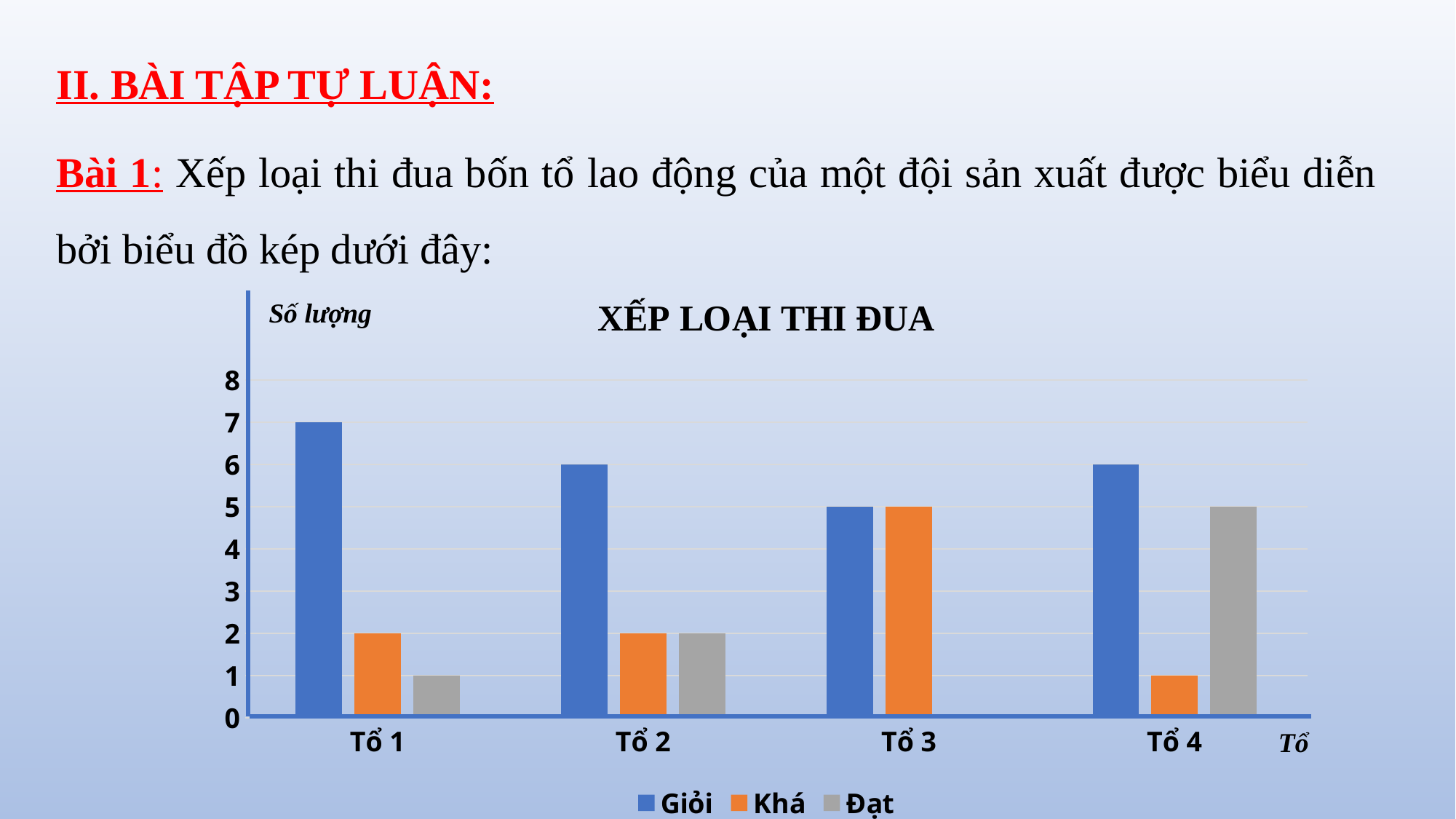
How many categories (tổ) are shown on the x axis of the chart? 4 Which tổ has the lowest Khá value? Tổ 4 Which is larger: the Đạt value for Tổ 2 or the Đạt value for Tổ 4? Tổ 4 What is the difference between the Giỏi value for Tổ 1 and the Giỏi value for Tổ 3? 2 What is the value of Giỏi for Tổ 1? 7 What is the value of Đạt for Tổ 4? 5 What is the value of Khá for Tổ 3? 5 What is the title of the chart? XẾP LOẠI THI ĐUA What kind of chart is shown on the slide? bar chart Which tổ has the highest Giỏi value? Tổ 1 Is the Giỏi value for Tổ 2 greater or less than 4? greater How many series does the legend of the chart list? 3